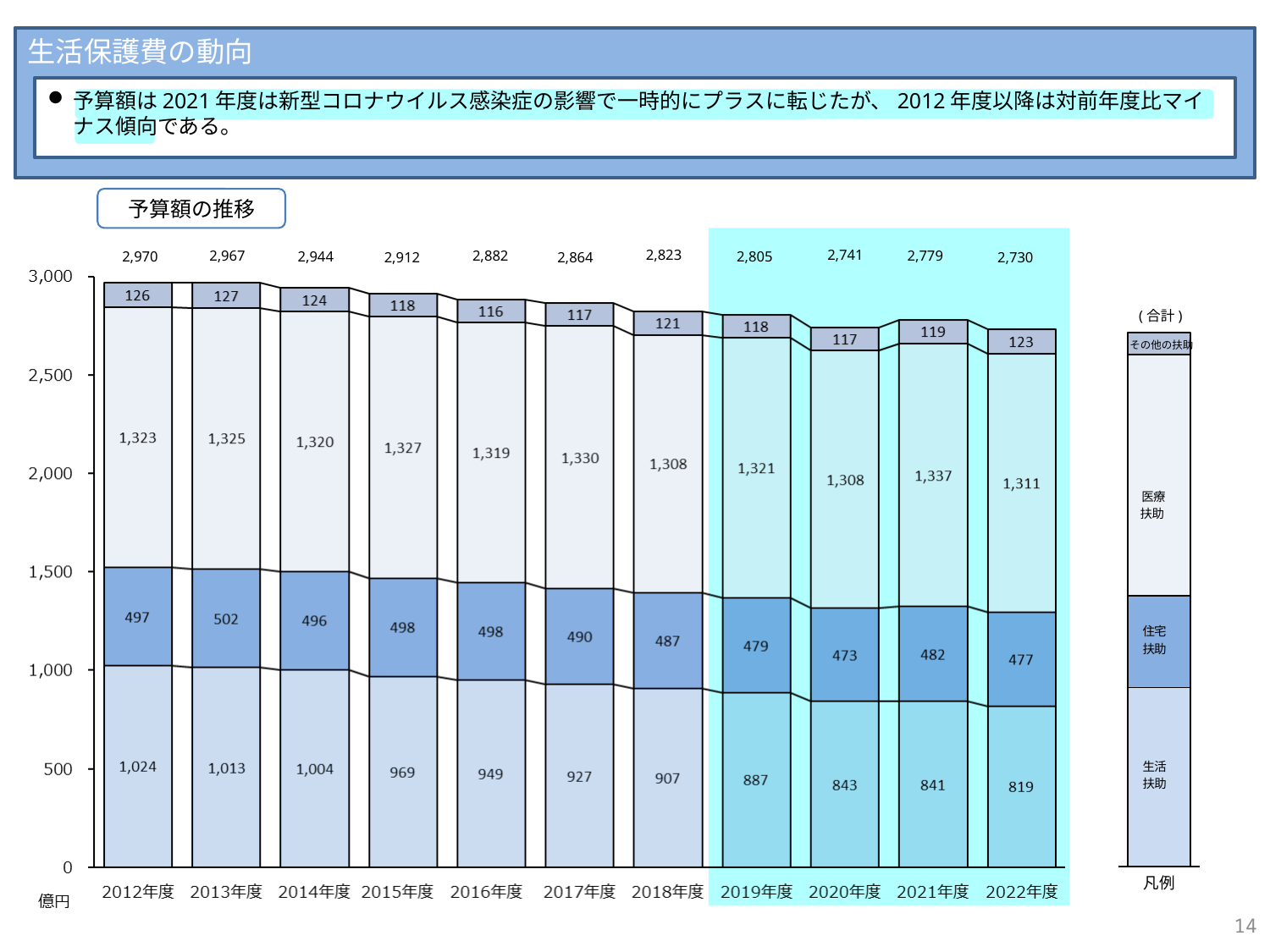
What is the total budget amount shown above the bar for 2022年度? 2,730 Which is larger, the 住宅扶助 value for 2013年度 or for 2020年度? 2013年度 What is the difference between the 生活扶助 value for 2012年度 and for 2022年度? 205 What unit is shown at the bottom left of the chart's y axis? 億円 What is the value of 生活扶助 for 2012年度? 1,024 How many categories does the legend (凡例) list? 4 How many fiscal years are shown on the x axis? 11 Does the 生活扶助 value rise or fall from 2012年度 to 2022年度? Fall Which year has the highest total budget amount? 2012年度 What is the value of 医療扶助 for 2021年度? 1,337 Which year has the lowest total budget amount? 2022年度 What kind of chart is shown on the slide? Stacked bar chart